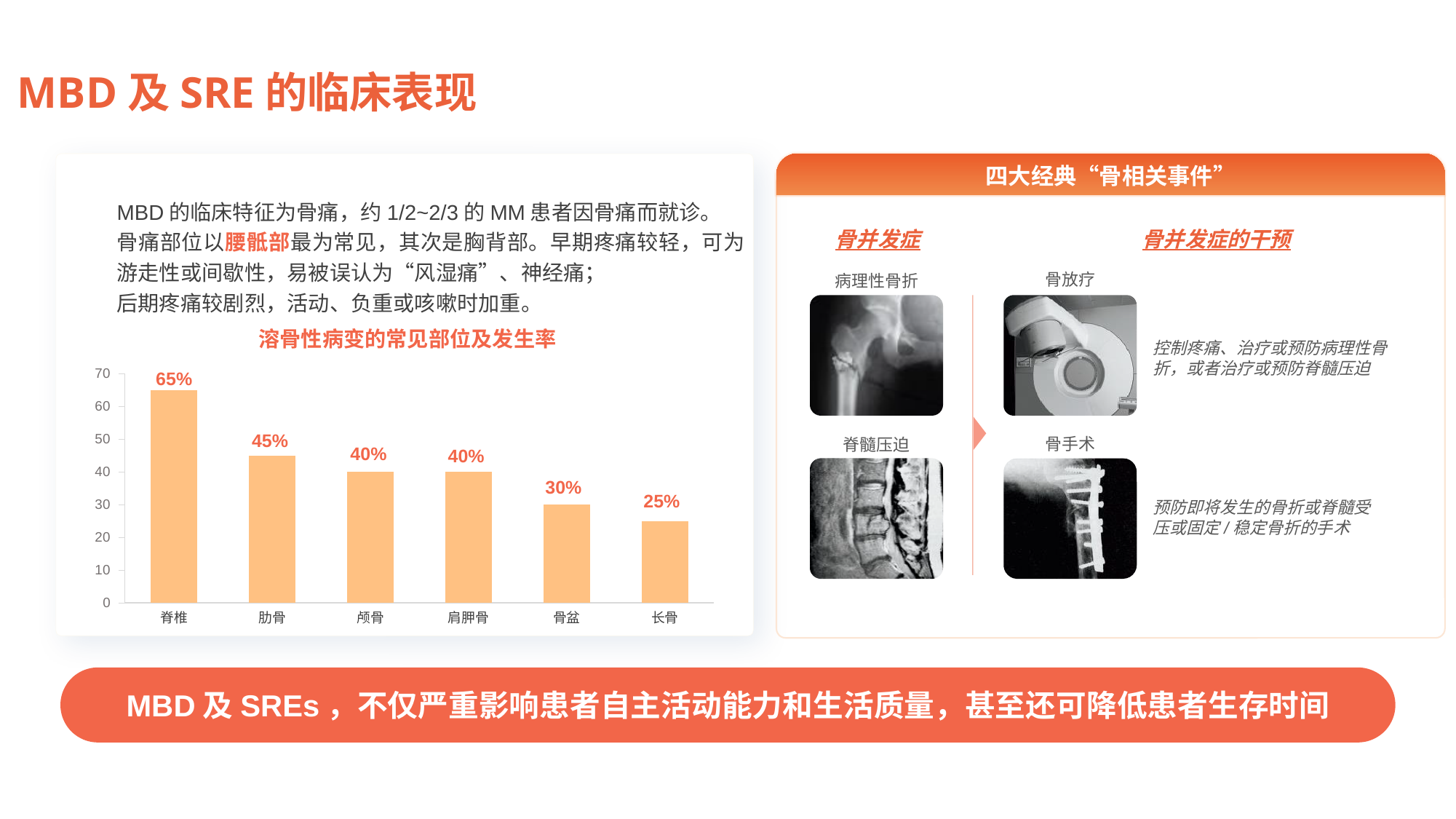
Do the values rise or fall from left to right along the x axis? Fall Which category has the highest value in the chart? 脊椎 Which is larger, the value for 骨盆 or the value for 长骨? 骨盆 What is the value for 肋骨 in the chart? 45% What is the value for 脊椎 in the chart? 65% Which category has the lowest value in the chart? 长骨 What is the title of the chart? 溶骨性病变的常见部位及发生率 What is the difference between the values for 脊椎 and 肋骨? 20% What is the value for 骨盆 in the chart? 30% How many categories are shown on the x axis of the chart? 6 What is the value for 长骨 in the chart? 25% What kind of chart is shown on the slide? Bar chart